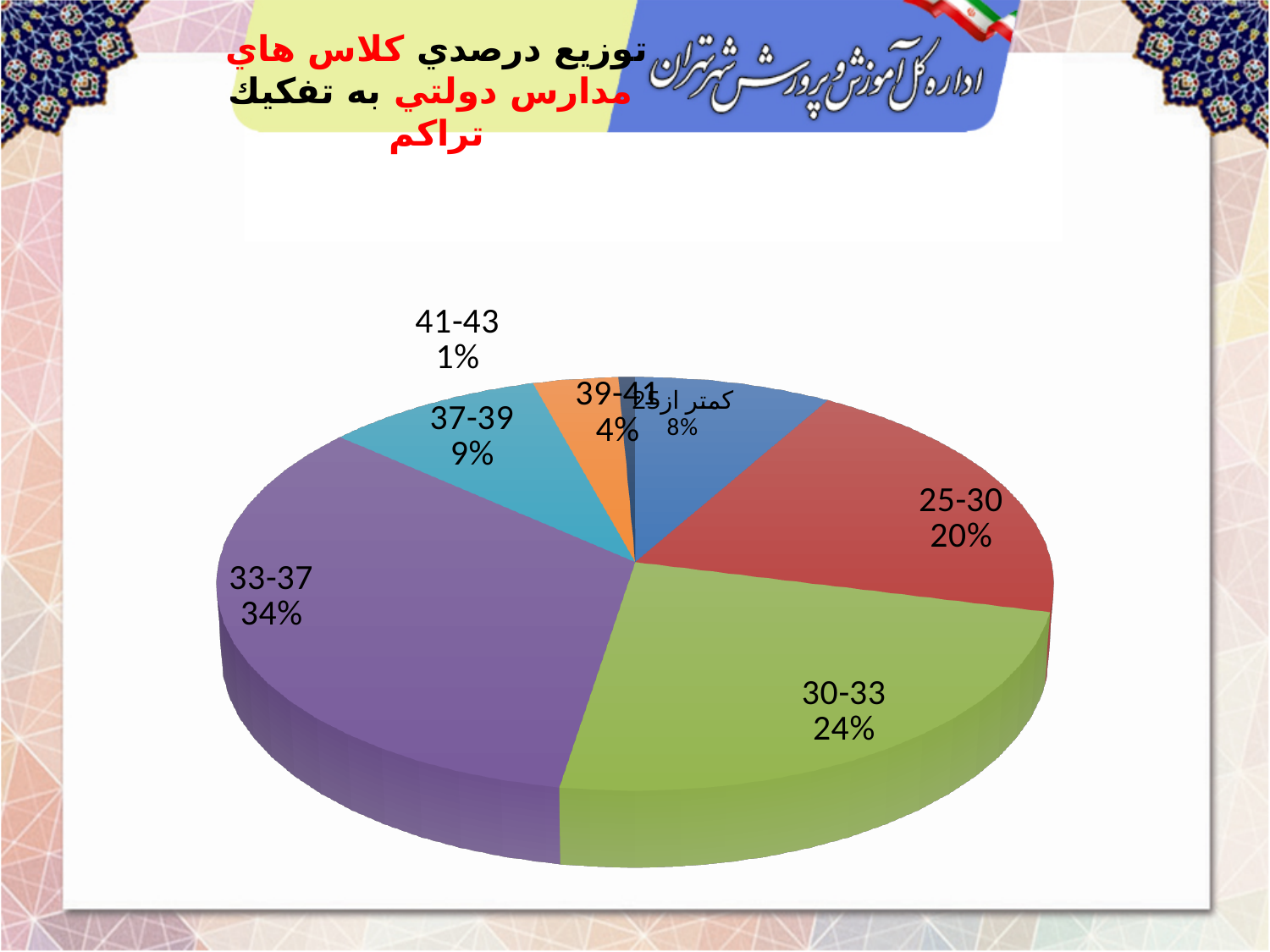
What is the value shown for the 37-39 category? 9% What is the difference in percentage points between the 33-37 slice and the 30-33 slice? 10 What percentage of the pie does the 33-37 slice represent? 34% How many slices does the pie chart have? 7 What is the value shown for the 30-33 category? 24% Which category has the smallest slice of the pie? 41-43 What is the value shown for the 25-30 category? 20% What is the value shown for the 39-41 category? 4% Which slice is larger, 25-30 or 30-33? 30-33 Which category has the largest slice of the pie? 33-37 What kind of chart is shown on the slide? pie chart What is the value shown for the 41-43 category? 1%